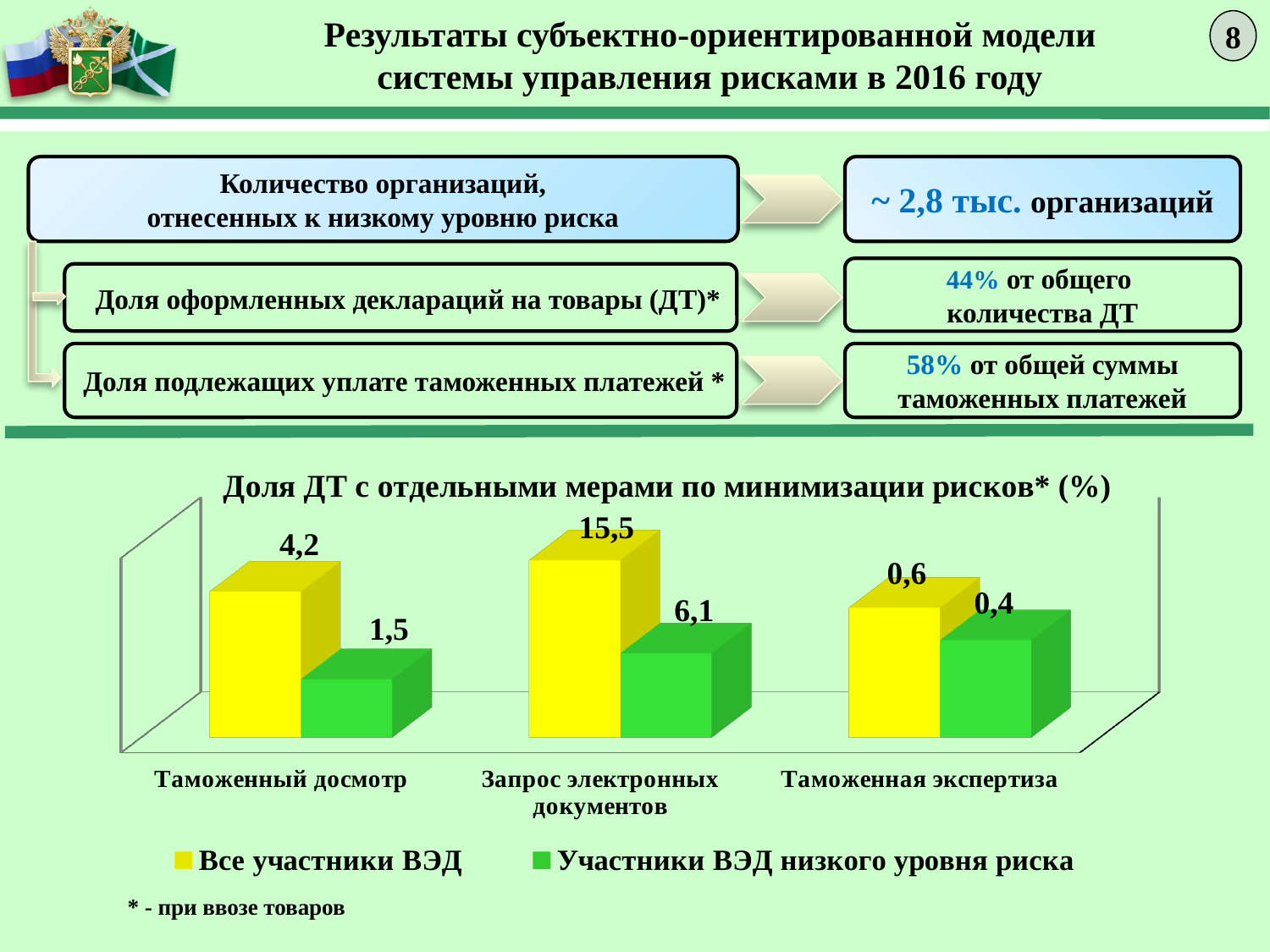
Which category has the highest value for "Все участники ВЭД"? Запрос электронных документов What is the difference between "Все участники ВЭД" and "Участники ВЭД низкого уровня риска" in the "Запрос электронных документов" category? 9,4 What is the value for "Все участники ВЭД" in the "Таможенная экспертиза" category? 0,6 How many categories are shown on the x axis of the chart? 3 What is the value for "Участники ВЭД низкого уровня риска" in the "Таможенный досмотр" category? 1,5 What is the title of the chart? Доля ДТ с отдельными мерами по минимизации рисков* (%) What is the value for "Все участники ВЭД" in the "Таможенный досмотр" category? 4,2 How many series does the chart legend list? 2 What is the value for "Участники ВЭД низкого уровня риска" in the "Запрос электронных документов" category? 6,1 In the "Таможенный досмотр" category, which series has the larger value? Все участники ВЭД What kind of chart is shown on the slide? Bar chart Which category has the lowest value for "Участники ВЭД низкого уровня риска"? Таможенная экспертиза